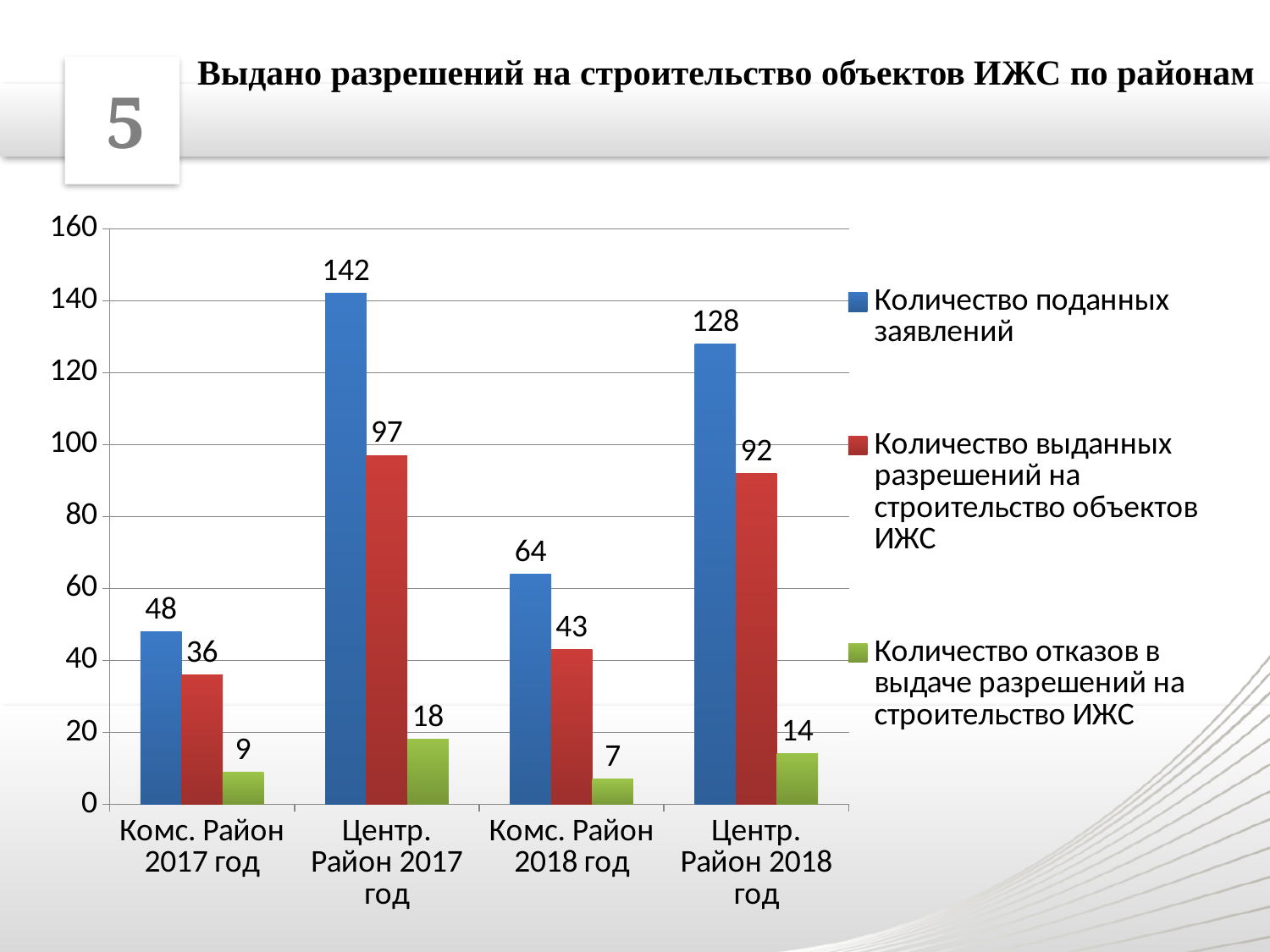
Which is larger: "Количество поданных заявлений" for "Комс. Район 2017 год" or for "Комс. Район 2018 год"? Комс. Район 2018 год How many series does the legend list? 3 How many categories are shown on the x axis? 4 What is the value of "Количество отказов в выдаче разрешений на строительство ИЖС" for "Центр. Район 2018 год"? 14 What colour are the bars for "Количество отказов в выдаче разрешений на строительство ИЖС"? green What is the value of "Количество выданных разрешений на строительство объектов ИЖС" for "Комс. Район 2018 год"? 43 Which category has the lowest value for "Количество отказов в выдаче разрешений на строительство ИЖС"? Комс. Район 2018 год Is the value of "Количество выданных разрешений на строительство объектов ИЖС" for "Центр. Район 2017 год" greater or less than 80? greater What kind of chart is shown on the slide? bar chart Which category has the highest value for "Количество поданных заявлений"? Центр. Район 2017 год What is the difference between "Количество поданных заявлений" and "Количество выданных разрешений на строительство объектов ИЖС" for "Центр. Район 2018 год"? 36 What is the value of "Количество поданных заявлений" for "Центр. Район 2017 год"? 142